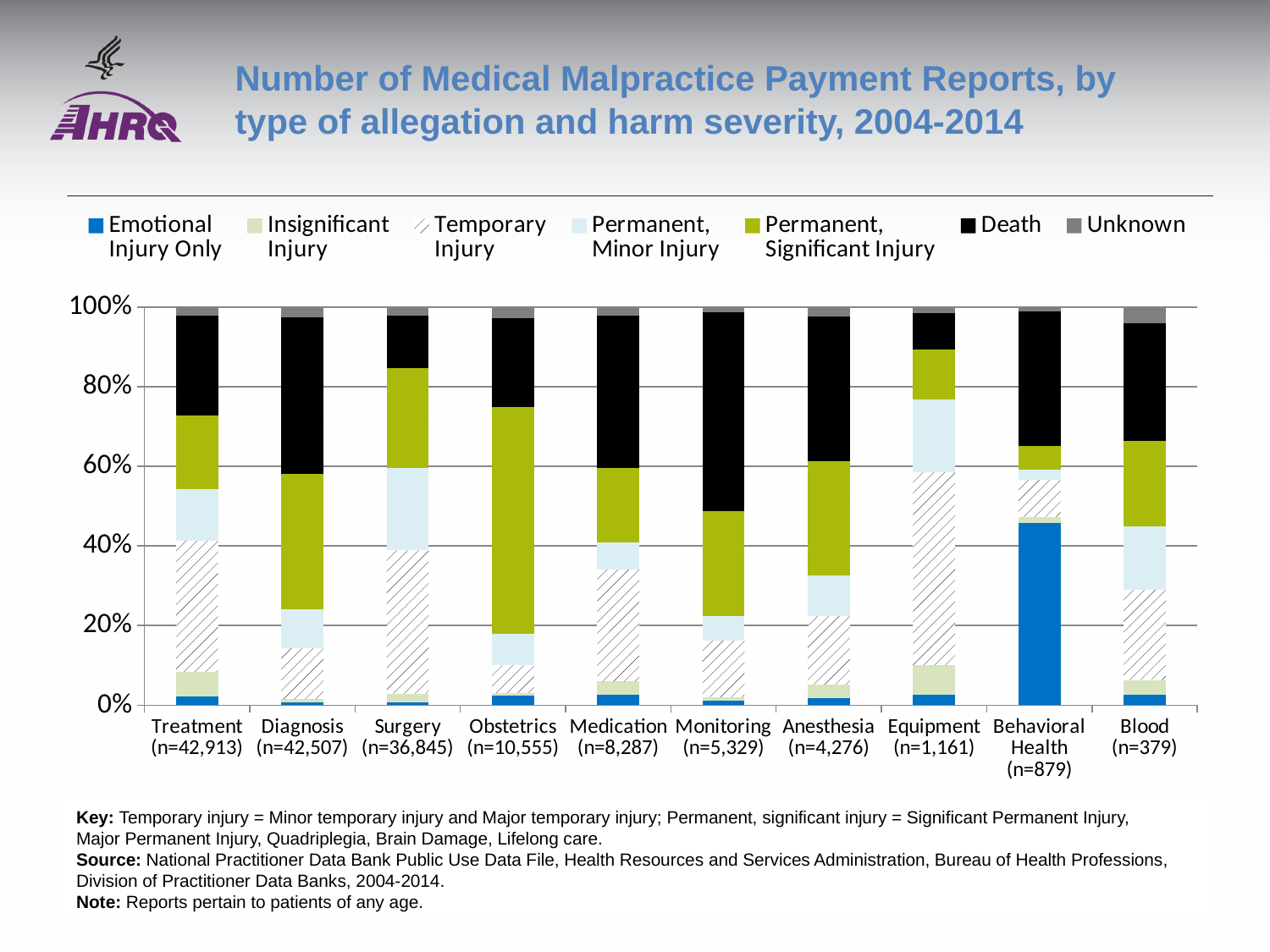
Is the Death share for Surgery greater or less than 20%? less What is the number of reports (n) shown for the Treatment category? n=42,913 Is the Death share for Monitoring greater or less than 40%? greater Is the Emotional Injury Only share for Behavioral Health greater or less than 40%? greater Which allegation type has the largest share of Death reports? Monitoring Is the Death share larger for Diagnosis or for Surgery? Diagnosis What kind of chart is shown on the slide? Stacked bar chart Which allegation type has the largest share of Emotional Injury Only reports? Behavioral Health Which series is shown in black in the legend? Death How many allegation types (categories) are shown along the x axis? 10 Which allegation type has the largest share of Permanent, Significant Injury reports? Obstetrics How many harm severity series does the legend list? 7